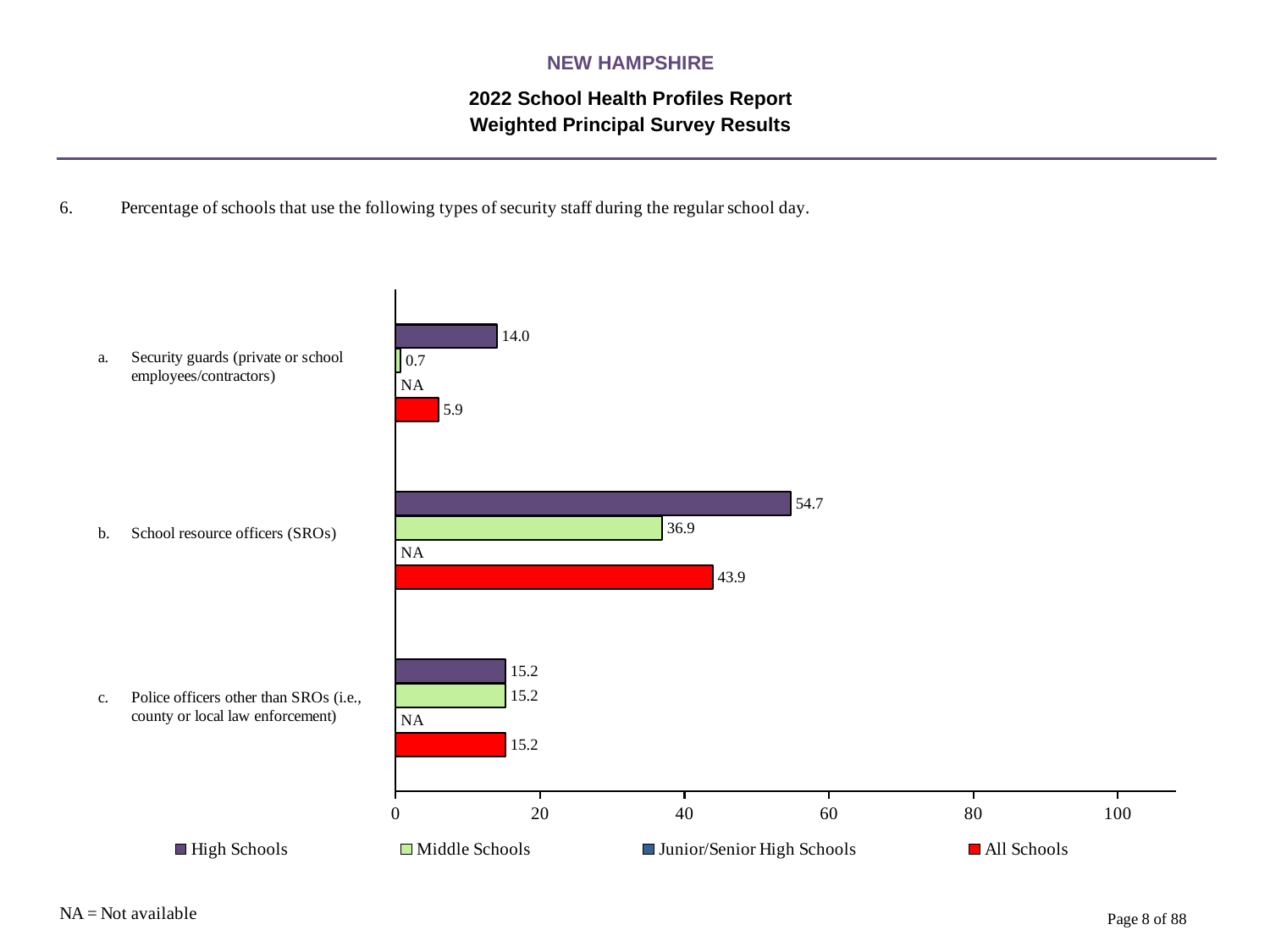
Which is larger for Security guards: the High Schools value or the All Schools value? High Schools What is the value for All Schools for Security guards? 5.9 What is the difference between the High Schools and Middle Schools values for School resource officers (SROs)? 17.8 How many series does the legend list? 4 What is the value for All Schools for Police officers other than SROs? 15.2 What kind of chart is shown on the slide? Bar chart Which category has the highest value for High Schools? School resource officers (SROs) Which category has the lowest value for Middle Schools? Security guards (private or school employees/contractors) What value is shown for Junior/Senior High Schools in every category? NA What is the value for Middle Schools for Security guards (private or school employees/contractors)? 0.7 How many categories of security staff are shown in the chart? 3 What is the value for High Schools for School resource officers (SROs)? 54.7